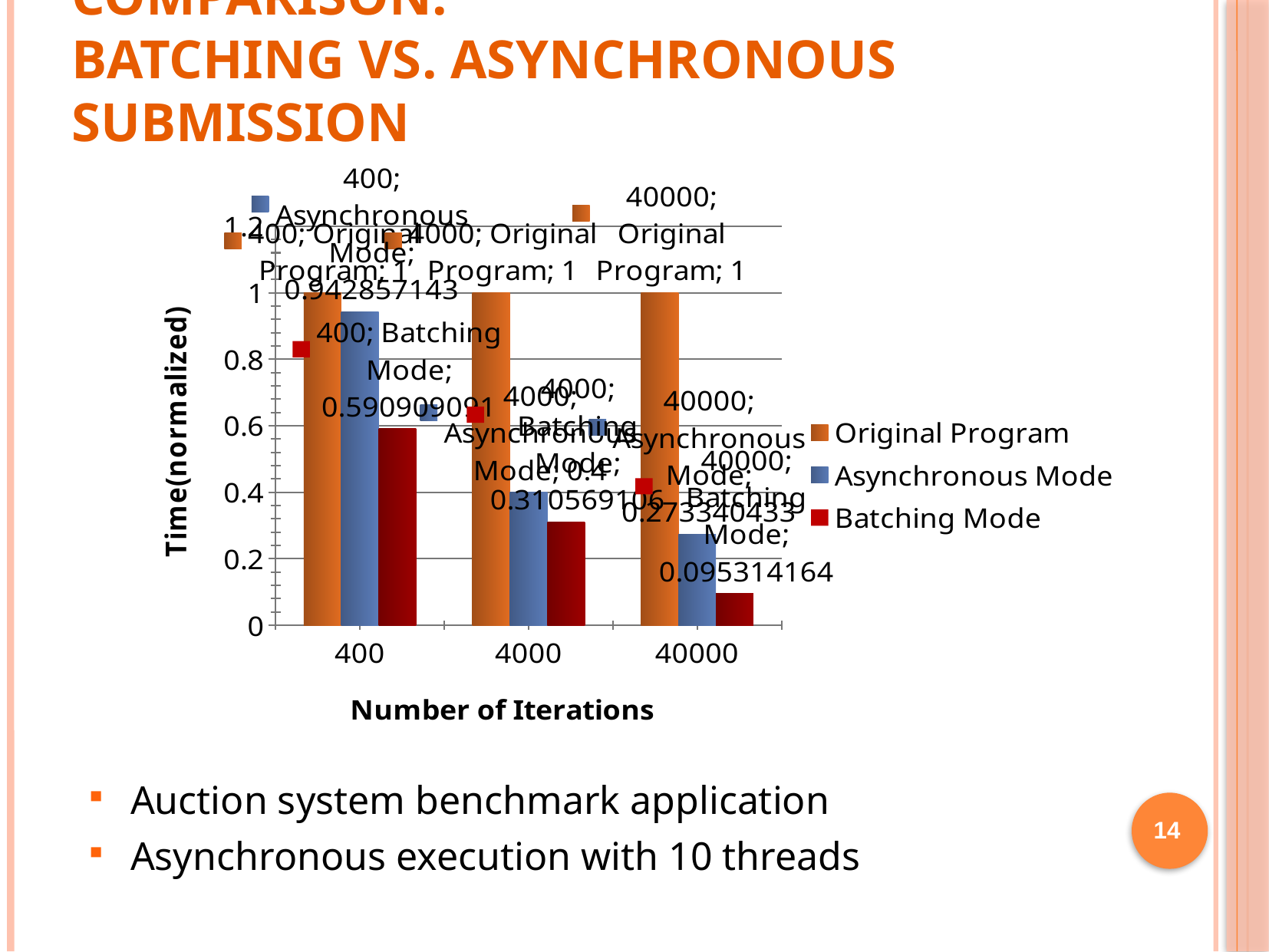
What is the label of the y axis? Time(normalized) What type of chart is shown on the slide? bar chart What is the value for Original Program at 40000 iterations? 1 What is the value for Batching Mode at 400 iterations? 0.590909091 How many series does the legend list? 3 Does the Batching Mode value rise or fall as the number of iterations increases? fall What is the value for Asynchronous Mode at 4000 iterations? 0.4 What is the value for Asynchronous Mode at 400 iterations? 0.942857143 Which is larger at 4000 iterations: Asynchronous Mode or Batching Mode? Asynchronous Mode Which series has the lowest value at 40000 iterations? Batching Mode How many categories are shown on the x axis (Number of Iterations)? 3 What is the value for Batching Mode at 40000 iterations? 0.095314164